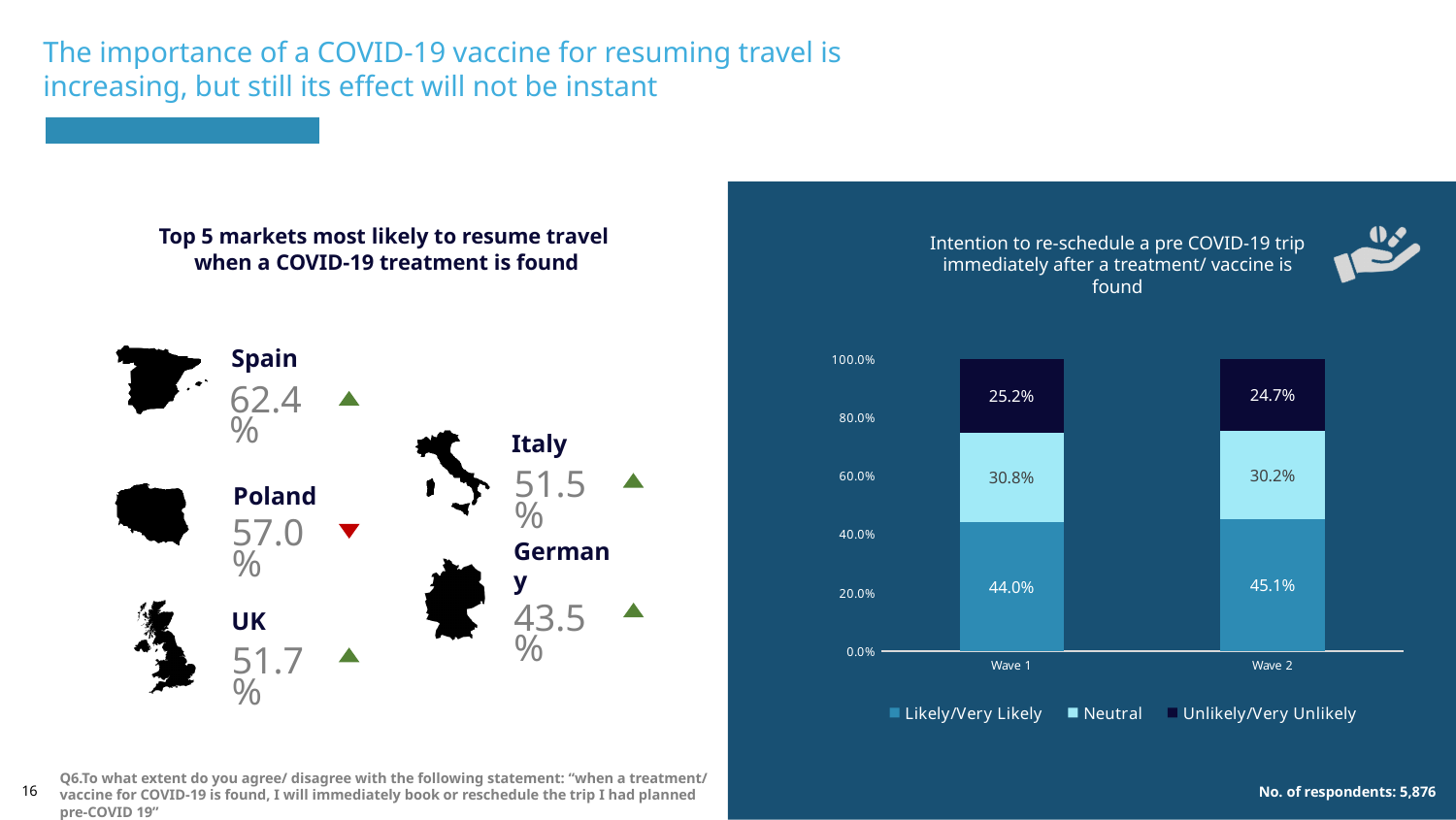
In the stacked bar chart, what is the Unlikely/Very Unlikely value for Wave 1? 25.2% How many series does the legend of the stacked bar chart list? 3 In the stacked bar chart, does the Unlikely/Very Unlikely share rise or fall from Wave 1 to Wave 2? Fall What are the three legend entries of the stacked bar chart? Likely/Very Likely, Neutral, Unlikely/Very Unlikely In the stacked bar chart, what is the Neutral value for Wave 2? 30.2% How many waves (categories) are shown on the x axis of the stacked bar chart? 2 In the stacked bar chart, by how many percentage points does the Likely/Very Likely share in Wave 2 exceed that in Wave 1? 1.1 percentage points In the stacked bar chart, which wave has the larger Likely/Very Likely share, Wave 1 or Wave 2? Wave 2 What kind of chart is used to show the intention to re-schedule a pre COVID-19 trip? Stacked bar chart In the stacked bar chart, what is the difference between the Unlikely/Very Unlikely shares of Wave 1 and Wave 2? 0.5 percentage points In the stacked bar chart, what is the Likely/Very Likely value for Wave 1? 44.0% In the stacked bar chart, what is the Likely/Very Likely value for Wave 2? 45.1%